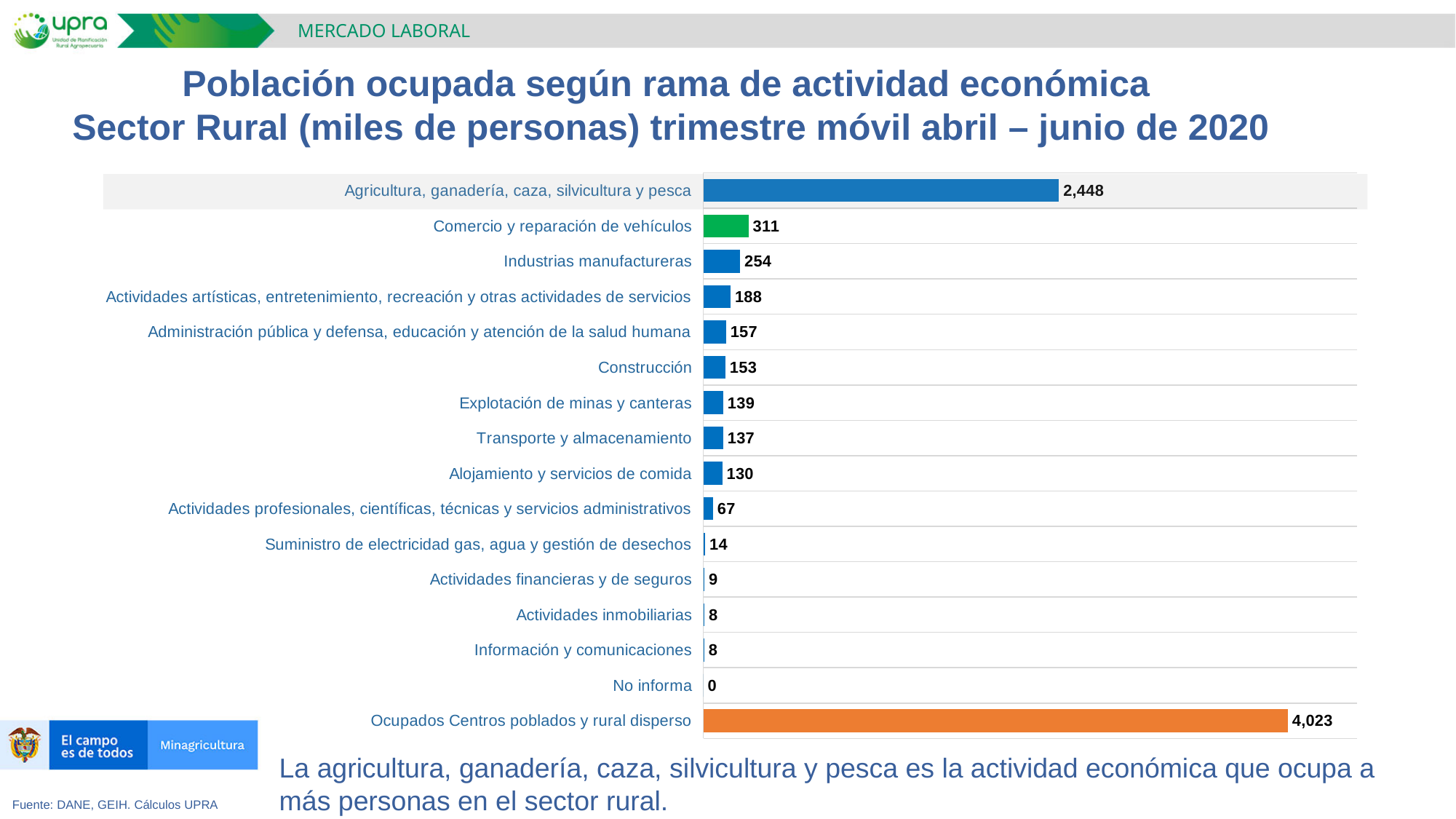
What colour is the bar for Comercio y reparación de vehículos? Green What is the difference between the values for Industrias manufactureras and Actividades artísticas, entretenimiento, recreación y otras actividades de servicios? 66 What is the difference between the values for Agricultura, ganadería, caza, silvicultura y pesca and Comercio y reparación de vehículos? 2,137 Which category has the longest bar in the chart? Ocupados Centros poblados y rural disperso Which is larger, the value for Transporte y almacenamiento or the value for Alojamiento y servicios de comida? Transporte y almacenamiento What is the value for Construcción? 153 What is the value for Agricultura, ganadería, caza, silvicultura y pesca? 2,448 What is the value for Ocupados Centros poblados y rural disperso? 4,023 Which category has the lowest value in the chart? No informa What is the value for Comercio y reparación de vehículos? 311 What kind of chart is shown on the slide? Bar chart How many categories are shown in the chart? 16